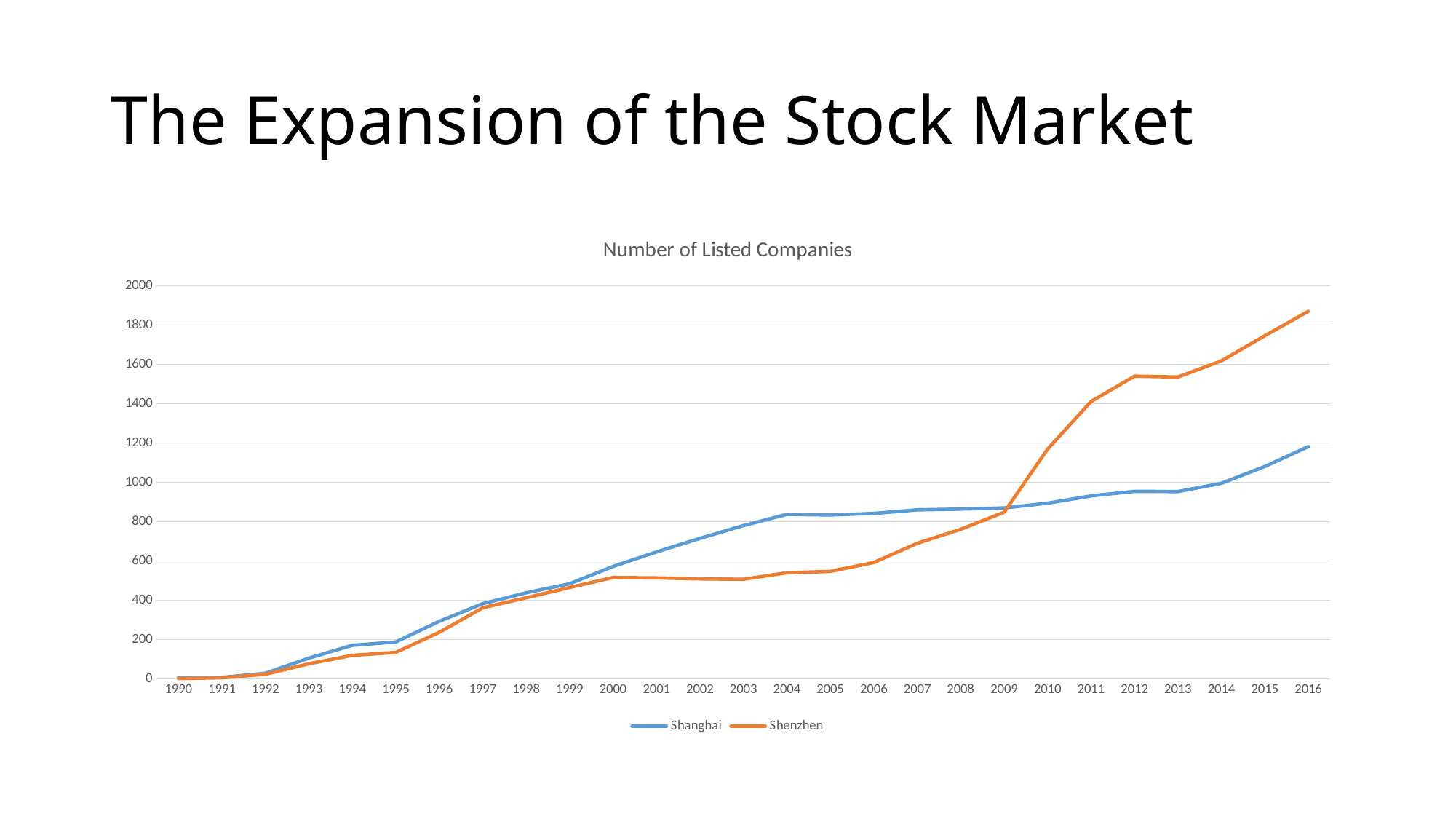
In 2016, which series has the larger value, Shanghai or Shenzhen? Shenzhen What kind of chart is shown on the slide? line chart In 2004, which series has the larger value, Shanghai or Shenzhen? Shanghai Is the value for Shenzhen in 2016 greater or less than 1800? greater Which two series are shown in the legend? Shanghai and Shenzhen How many series does the legend list? 2 In which year does the Shenzhen series reach its highest value? 2016 Is the value for Shenzhen in 2005 greater or less than 600? less Is the value for Shanghai in 2016 greater or less than 1000? greater What is the title of the chart? Number of Listed Companies How many years are shown along the x axis? 27